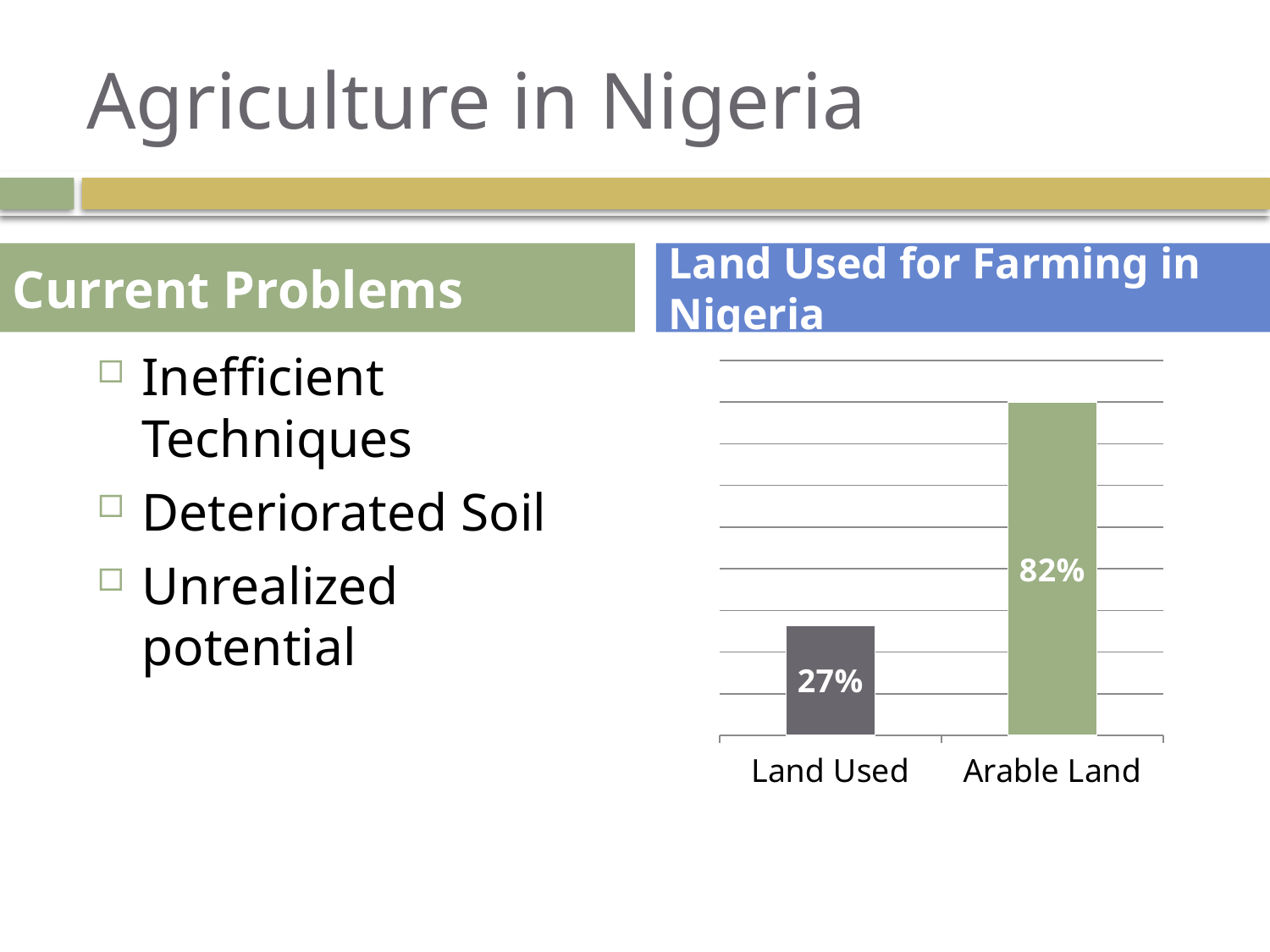
What is the difference between the values for Arable Land and Land Used? 55% Which category has the highest value? Arable Land What colour is the bar for Arable Land? Green Do the values rise or fall from Land Used to Arable Land? Rise What is the value for Arable Land? 82% How many categories are shown on the chart? 2 Which is larger, the value for Land Used or the value for Arable Land? Arable Land What is the value for Land Used? 27% What is the title of the chart section on the slide? Land Used for Farming in Nigeria Which category has the lowest value? Land Used What kind of chart is shown on the slide? Bar chart